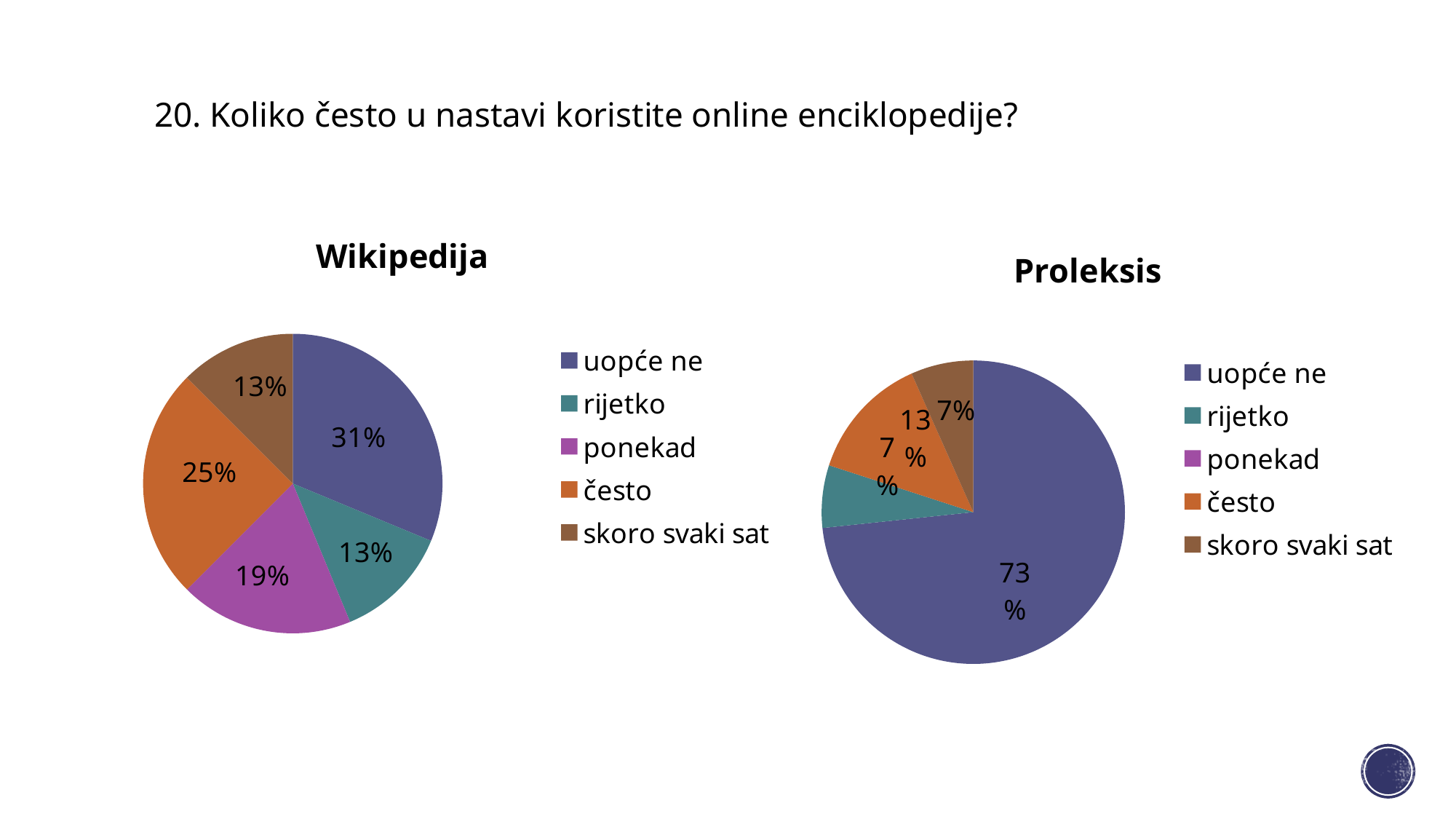
In the Wikipedija chart, what is the combined share of "rijetko" and "skoro svaki sat"? 26% What is the difference between the "uopće ne" share in the Proleksis chart and the "uopće ne" share in the Wikipedija chart? 42% In the Wikipedija chart, which is larger: the share for "često" or the share for "ponekad"? često In the Proleksis chart, what percentage is shown for "često"? 13% In the Wikipedija chart, what percentage is shown for "često"? 25% In the Proleksis chart, which category has the largest share? uopće ne What type of chart is used for Wikipedija? Pie chart In the Wikipedija chart, what percentage is shown for "ponekad"? 19% In the Wikipedija chart, which category has the largest share? uopće ne In the Wikipedija chart, what percentage is shown for "uopće ne"? 31% How many entries does the legend of the Proleksis chart list? 5 In the Proleksis chart, what percentage is shown for "uopće ne"? 73%